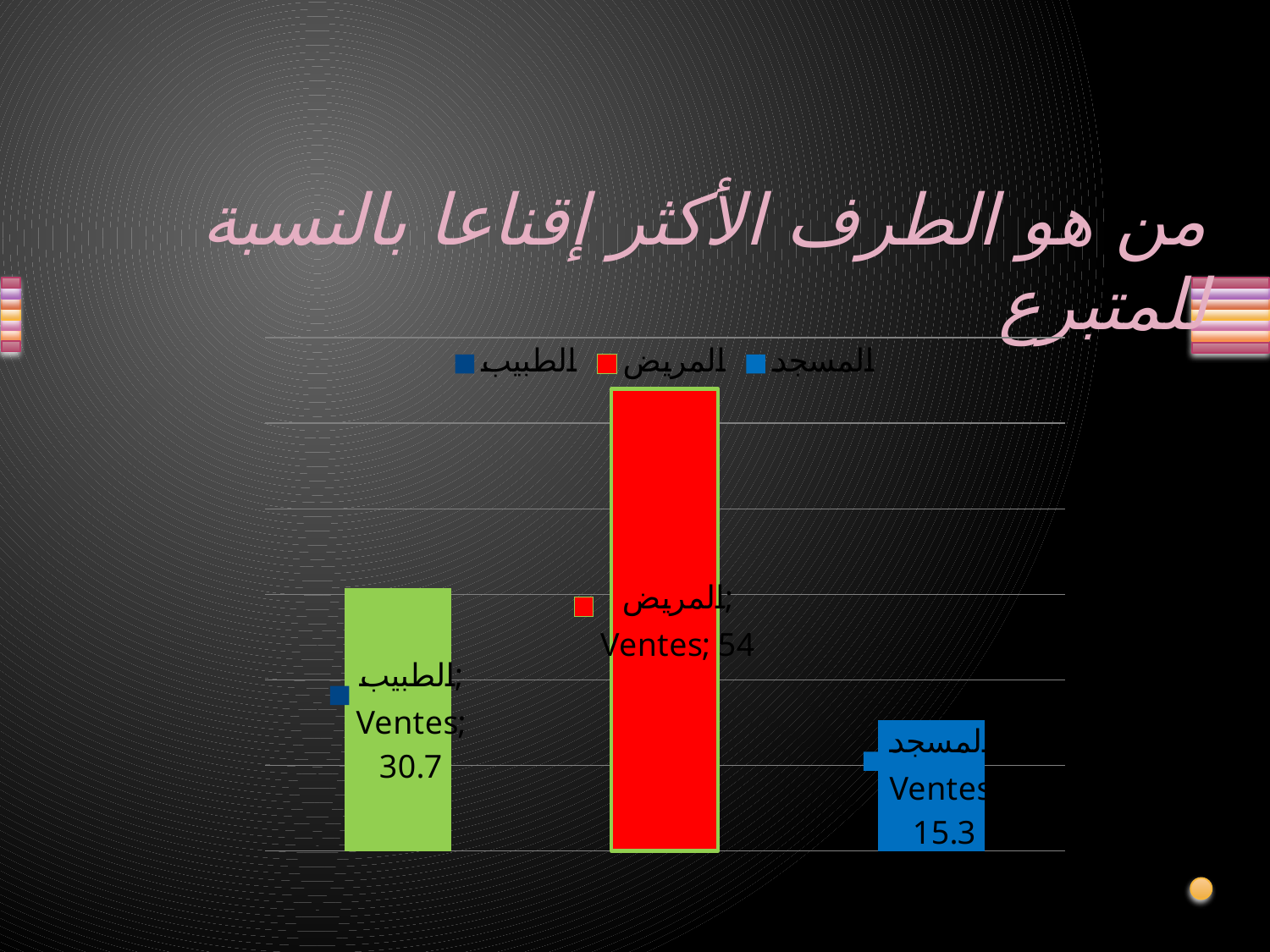
What is the value for الطبيب? 30.7 What is the value for المريض? 54 What is the difference between the values for المريض and الطبيب? 23.3 What is the value for المسجد? 15.3 Which category has the lowest value? المسجد Which is larger, the value for الطبيب or the value for المسجد? الطبيب What colour is the bar for المريض? red What is the difference between the values for الطبيب and المسجد? 15.4 How many bars are plotted in the chart? 3 How many entries does the legend list? 3 What kind of chart is shown on the slide? bar chart Which category has the highest value? المريض